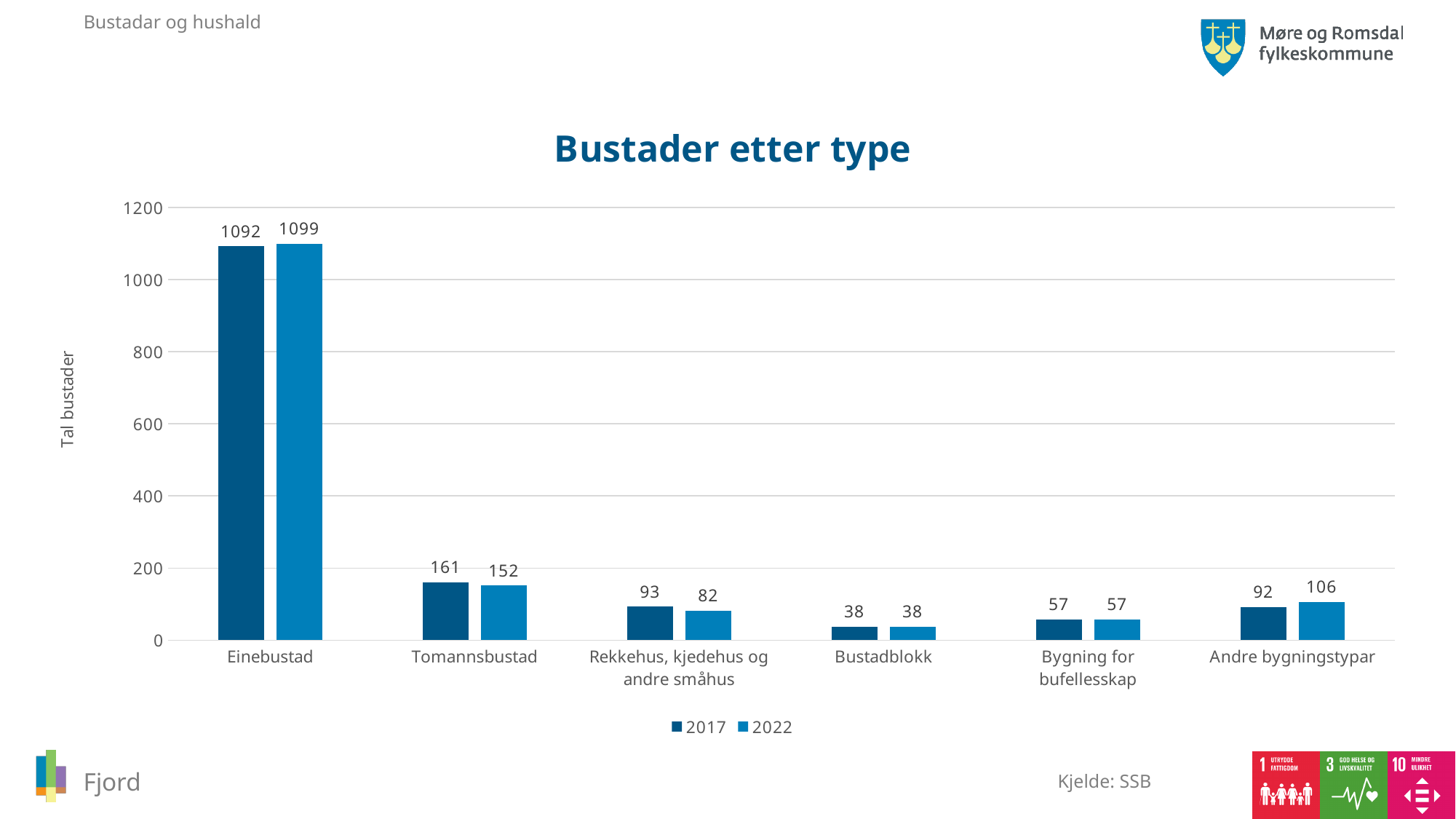
How many series does the legend list? 2 What is the title of the chart? Bustader etter type What is the value for Bustadblokk in 2022? 38 Which category has the highest value in 2017? Einebustad What is the value for Tomannsbustad in 2017? 161 Which category has the lowest value in 2022? Bustadblokk Is the value for Tomannsbustad in 2017 greater or less than 200? less Which is larger for Andre bygningstypar: the 2017 value or the 2022 value? 2022 How many categories are shown on the x axis? 6 What is the difference between the 2017 and 2022 values for Rekkehus, kjedehus og andre småhus? 11 What is the value for Einebustad in 2022? 1099 What kind of chart is shown? bar chart